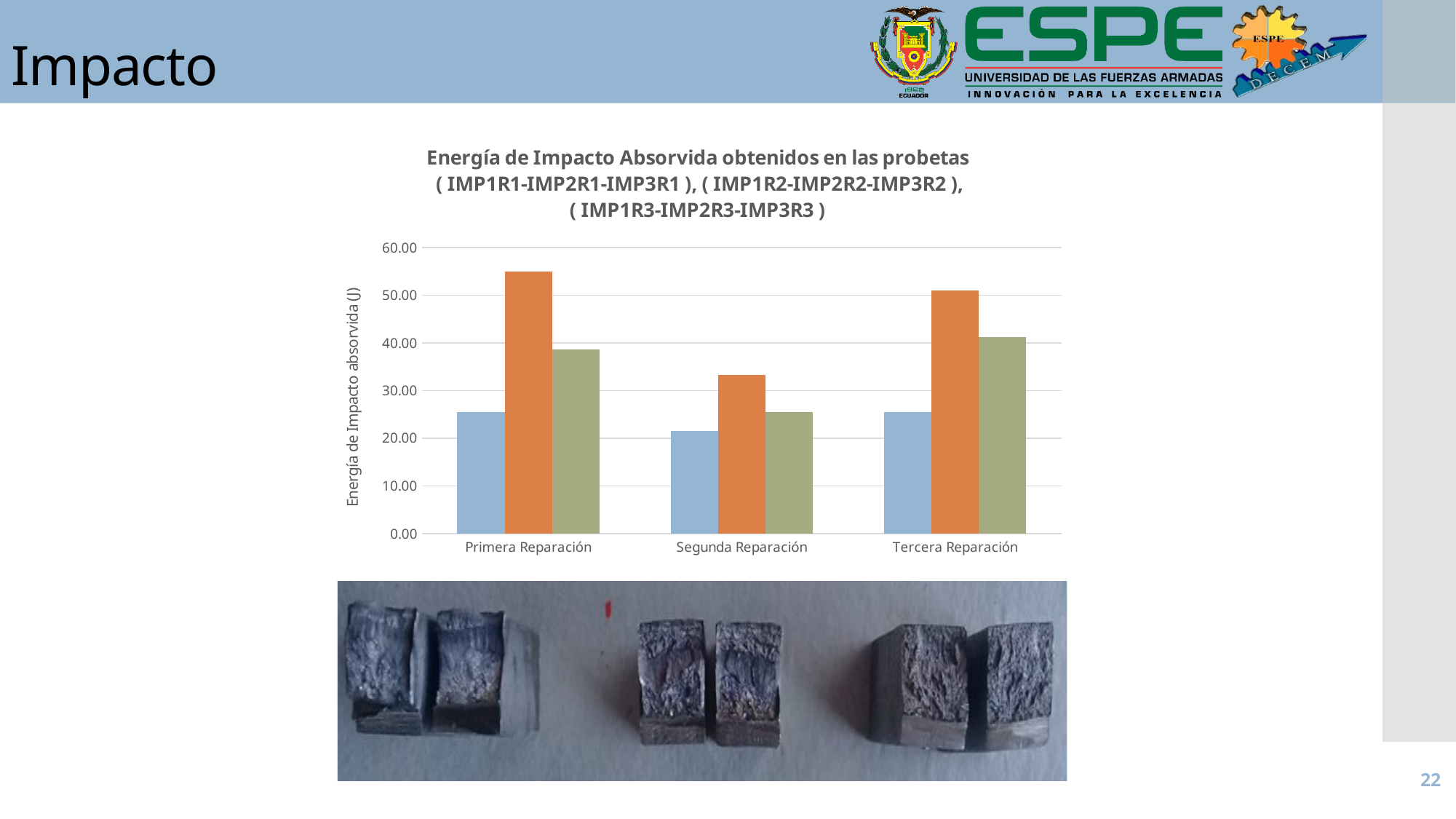
Which category has the tallest orange bar in the chart? Primera Reparación How many bars are plotted for each category in the chart? 3 How many categories are shown on the x axis of the chart? 3 In the Segunda Reparación category, which bar is taller, the orange bar or the green bar? orange bar What is the label of the y axis of the chart? Energía de Impacto absorvida (J) Which category has the shortest blue bar in the chart? Segunda Reparación Which category has the shortest orange bar in the chart? Segunda Reparación Which category has the tallest green bar in the chart? Tercera Reparación What kind of chart is shown on the slide? bar chart Is the blue bar for Segunda Reparación greater or less than 30.00? less Is the orange bar for Primera Reparación greater or less than 50.00? greater Is the green bar for Tercera Reparación greater or less than 40.00? greater